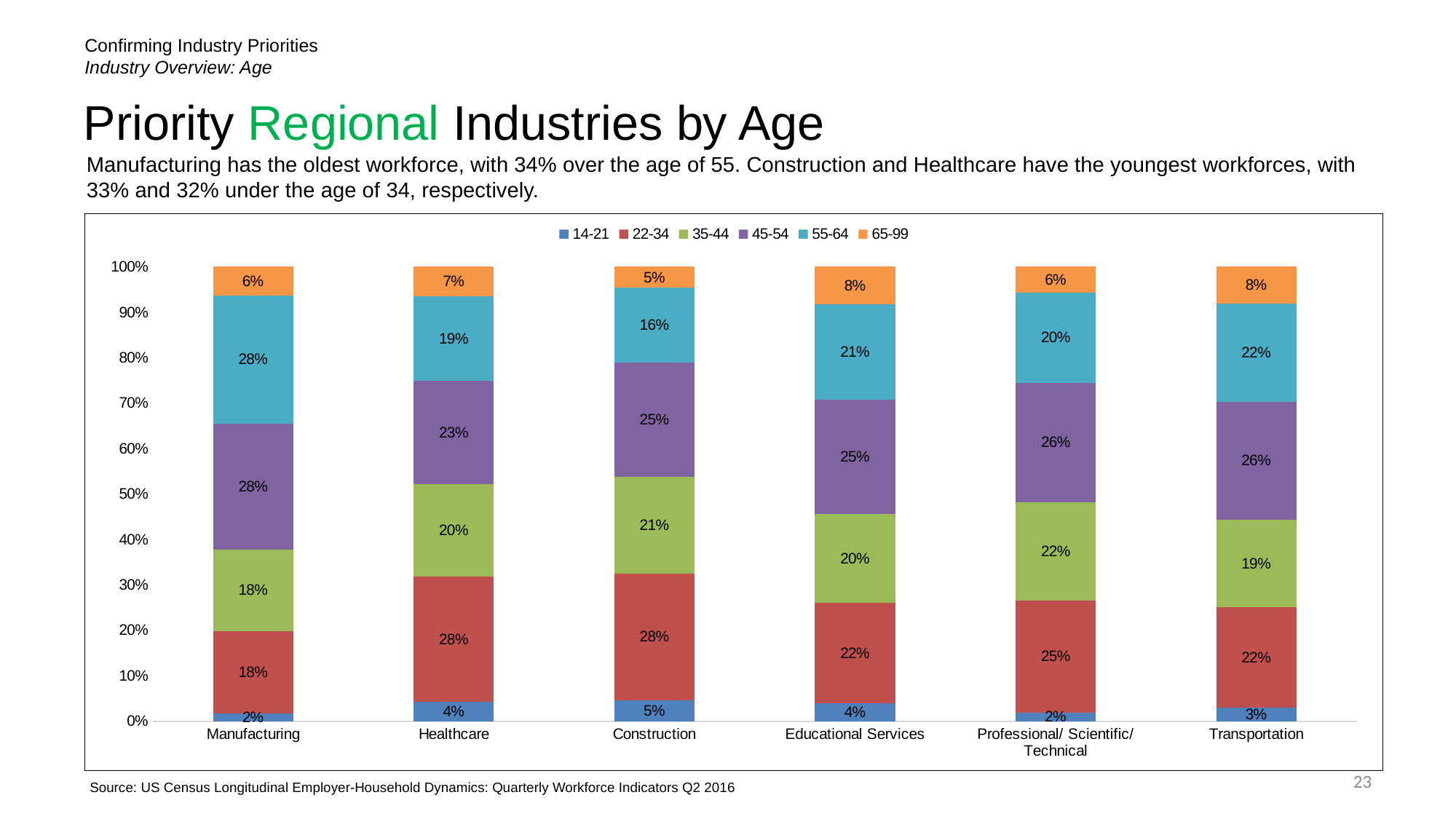
What is the 22-34 share for Healthcare? 28% How many industries are shown on the x axis? 6 Which industry has the lowest share of workers aged 55-64? Construction What percentage of the Transportation workforce is aged 65-99? 8% How many percentage points higher is the 55-64 share for Manufacturing than for Construction? 12 percentage points Which has a larger 45-54 share, Healthcare or Transportation? Transportation What percentage of the Manufacturing workforce is aged 55-64? 28% How many age groups does the legend list? 6 Which industry has the highest share of workers aged 55-64? Manufacturing What type of chart is shown on the slide? Stacked bar chart Which industry has the lowest share of workers aged 22-34? Manufacturing What is the 14-21 share for Construction? 5%